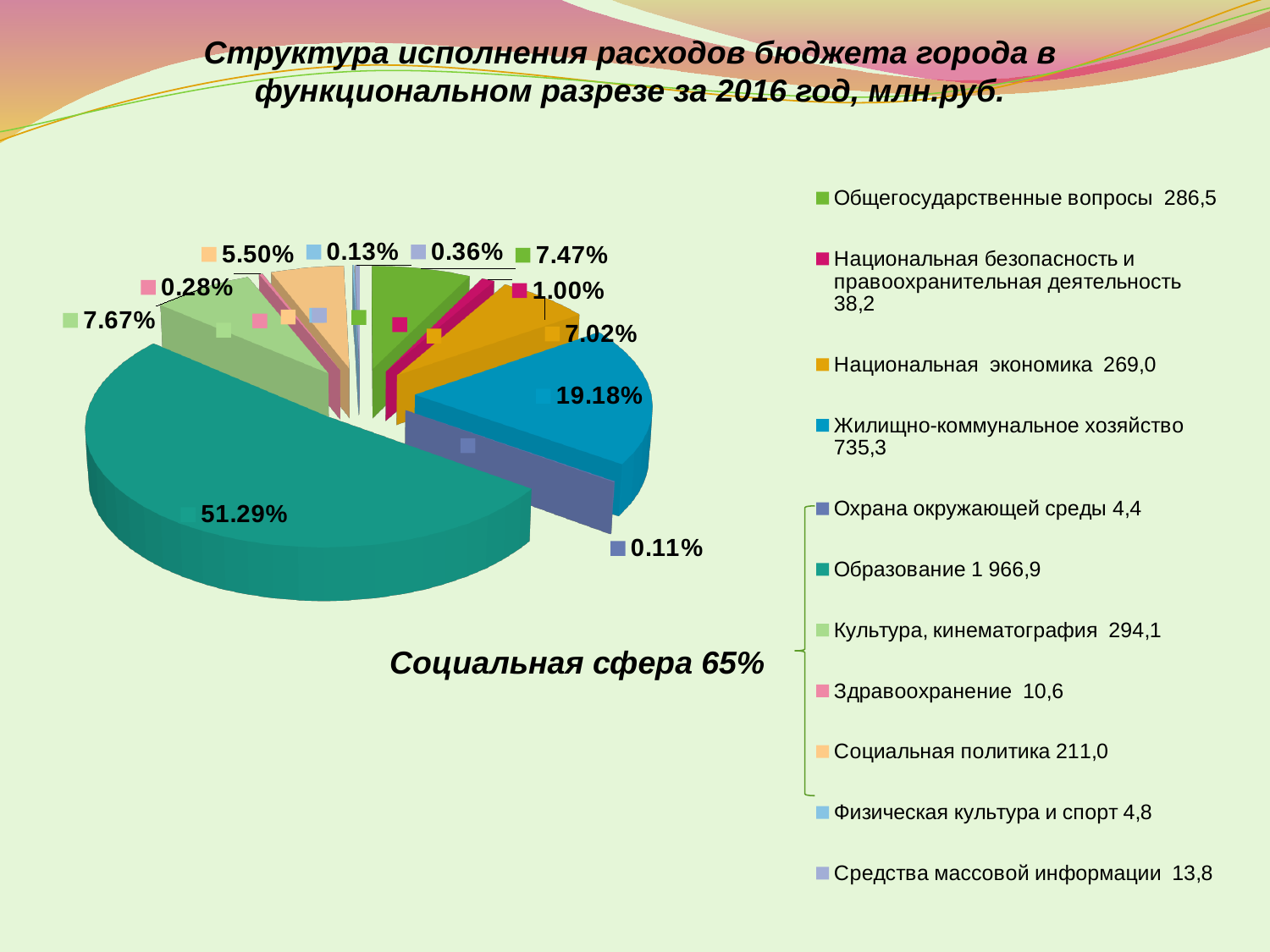
What value in million rubles is shown in the legend for Национальная экономика? 269,0 What kind of chart is shown on the slide? pie chart What share of the pie does Образование take? 51.29% What value in million rubles is shown in the legend for Культура, кинематография? 294,1 What value in million rubles is shown in the legend for Социальная политика? 211,0 Which category has the largest share of the pie? Образование How many categories does the legend of the pie chart list? 11 Which category has the smallest share of the pie? Охрана окружающей среды What is the difference between the values for Жилищно-коммунальное хозяйство (735,3) and Общегосударственные вопросы (286,5)? 448,8 What share of the pie does Жилищно-коммунальное хозяйство take? 19.18% Which is larger: the value for Общегосударственные вопросы or the value for Национальная экономика? Общегосударственные вопросы What percentage is given for Социальная сфера in the text below the pie chart? 65%